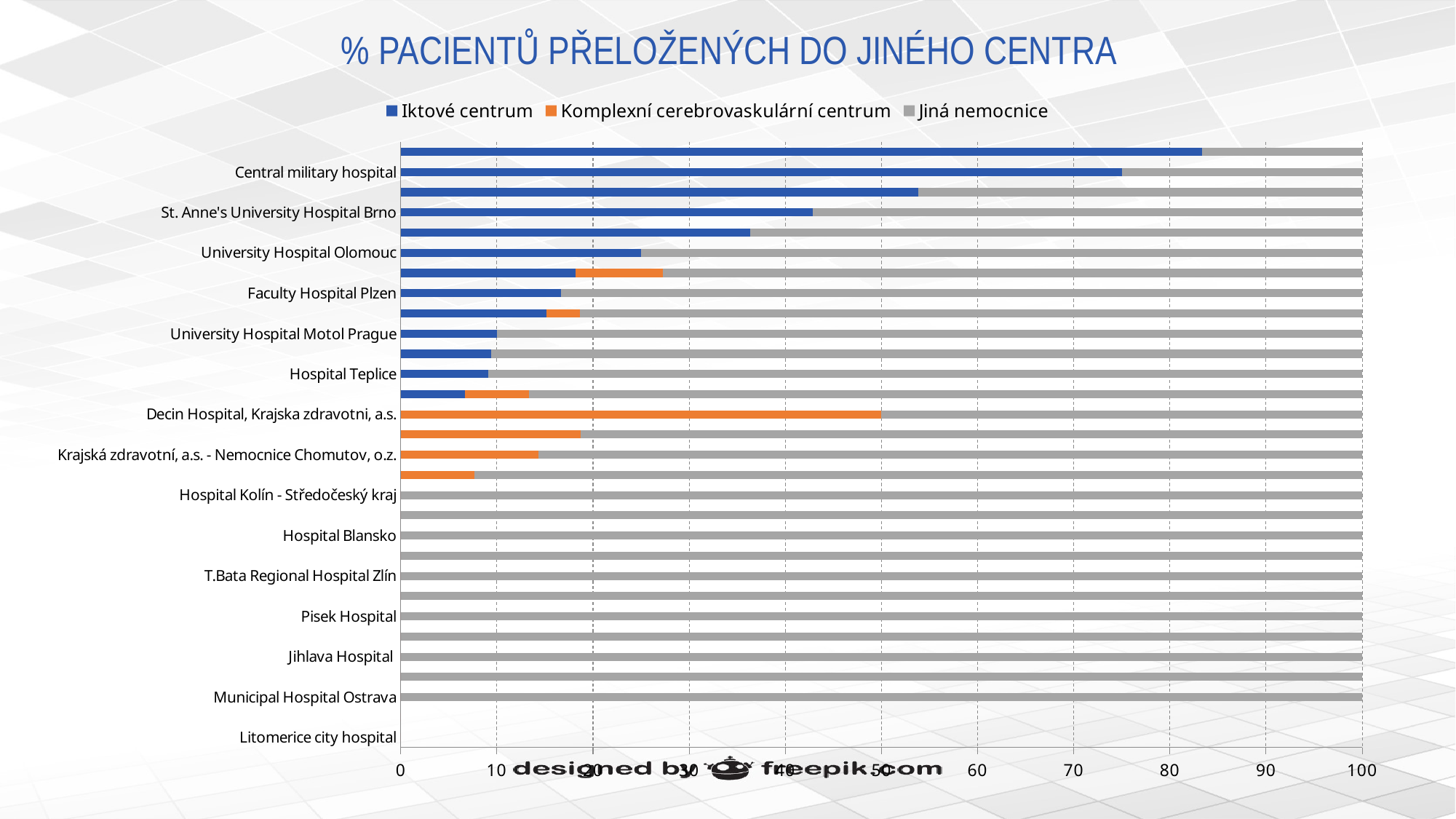
Is the Komplexní cerebrovaskulární centrum value for Decin Hospital, Krajska zdravotni, a.s. greater or less than 40? greater Which series is shown in orange in the legend? Komplexní cerebrovaskulární centrum Is the Iktové centrum value for University Hospital Olomouc greater or less than 30? less Which of the two has the larger Iktové centrum value: Central military hospital or University Hospital Olomouc? Central military hospital Is the Iktové centrum value for Faculty Hospital Plzen greater or less than 20? less What is the title of the chart? % PACIENTŮ PŘELOŽENÝCH DO JINÉHO CENTRA What kind of chart is shown on the slide? Stacked bar chart How many series does the legend list? 3